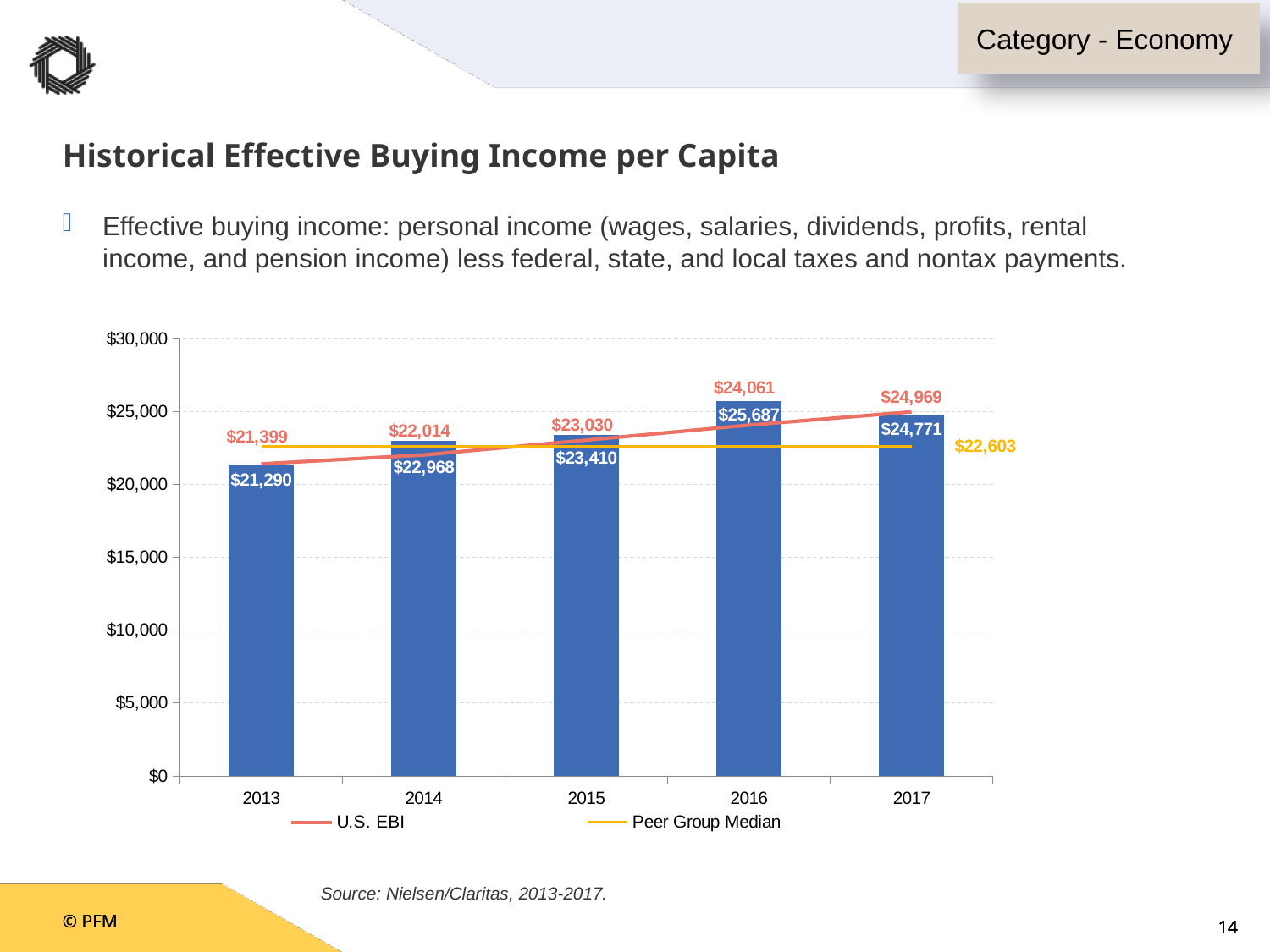
Which is larger in 2015, the bar value or the U.S. EBI value? the bar value ($23,410) How many series does the legend list? 2 Which year has the highest bar value? 2016 What value is shown for the Peer Group Median line? $22,603 What is the U.S. EBI value shown for 2014? $22,014 What is the difference between the bar values for 2016 and 2017? $916 Is the bar value for 2013 greater or less than $25,000? less Does the U.S. EBI line rise or fall from 2013 to 2017? rise Which year has the lowest bar value? 2013 What is the value of the bar for 2016? $25,687 What kind of chart is shown on the slide? bar chart with line overlays How many years are shown on the x axis? 5